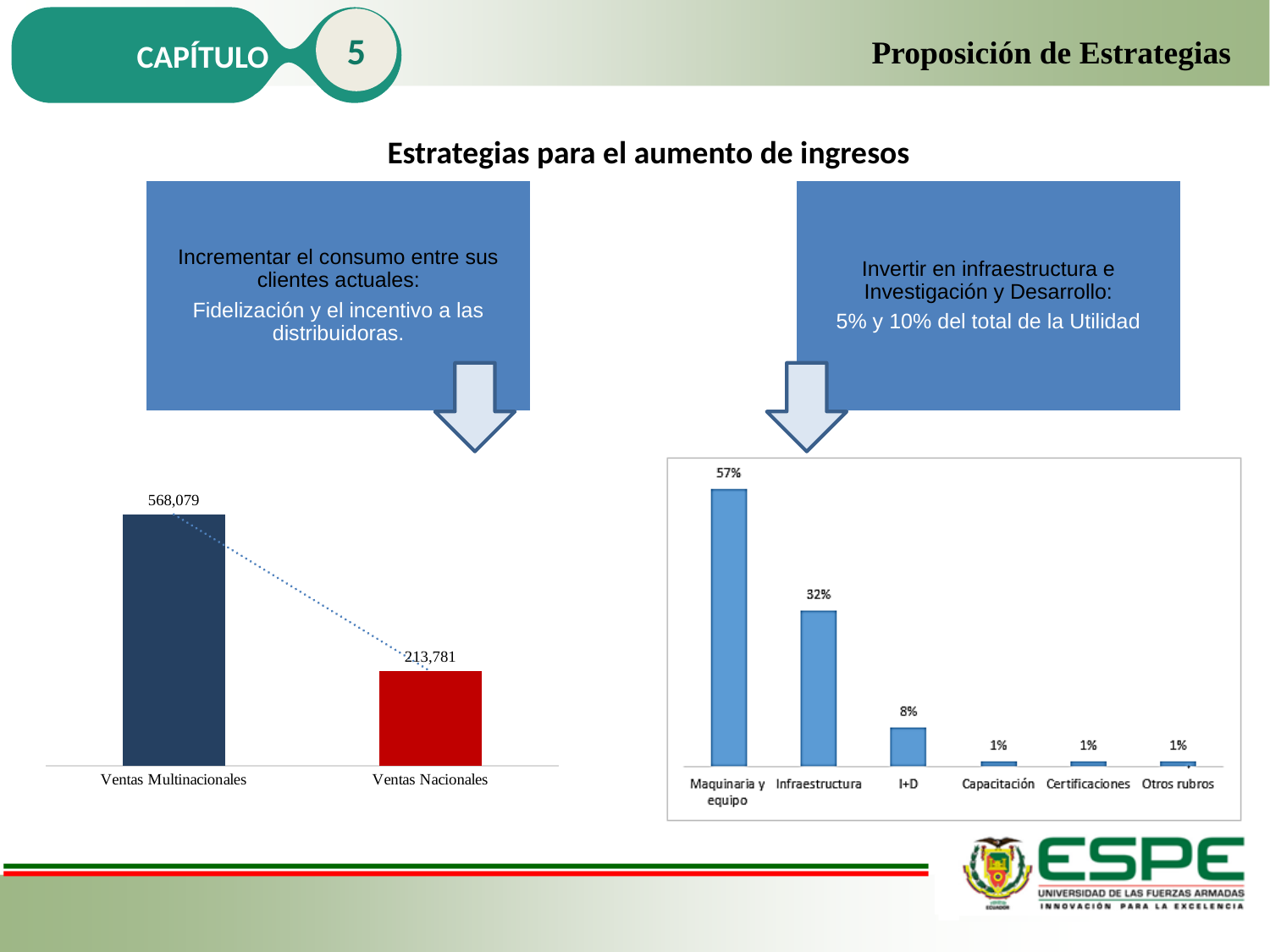
In the chart on the left of the slide, how many categories are shown? 2 In the chart on the right of the slide, which category has the highest value? Maquinaria y equipo In the chart on the left of the slide, what is the value for Ventas Nacionales? 213,781 What kind of chart is shown on the left of the slide? Bar chart In the chart on the left of the slide, what is the value for Ventas Multinacionales? 568,079 In the chart on the left of the slide, which category has the higher value? Ventas Multinacionales In the chart on the left of the slide, what is the difference between Ventas Multinacionales and Ventas Nacionales? 354,298 In the chart on the right of the slide, what is the value for I+D? 8% In the chart on the right of the slide, what is the value for Maquinaria y equipo? 57% In the chart on the right of the slide, what is the value for Infraestructura? 32% In the chart on the right of the slide, how many categories are shown? 6 In the chart on the right of the slide, what is the difference between Maquinaria y equipo and Infraestructura? 25%